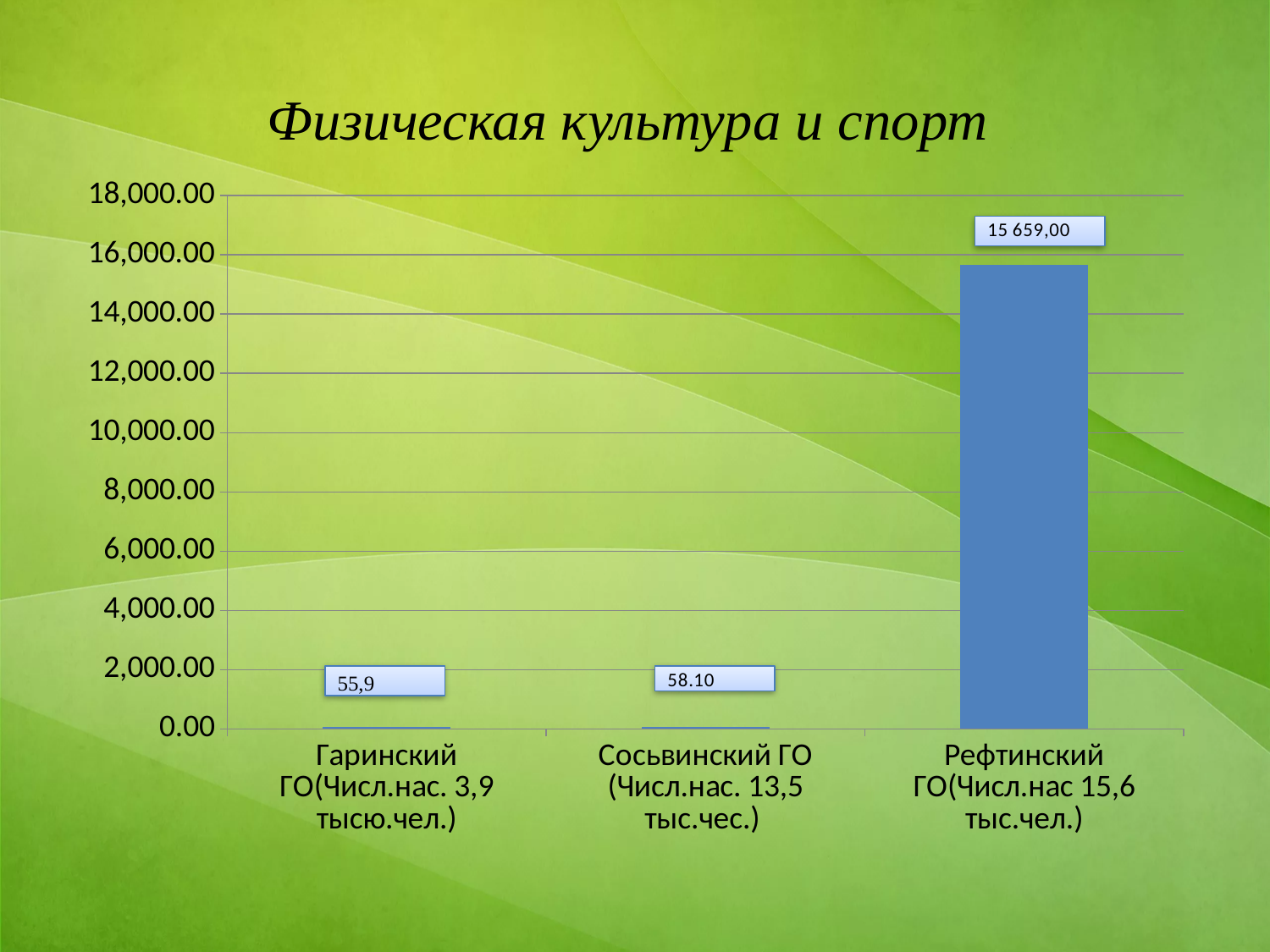
How many categories are shown on the chart? 3 What is the value shown for Гаринский ГО? 55,9 What is the value shown for Рефтинский ГО? 15 659,00 What is the title of the slide? Физическая культура и спорт Which category has the highest value? Рефтинский ГО Which category has the lowest value? Гаринский ГО Which is larger, the value for Рефтинский ГО or the value for Сосьвинский ГО? Рефтинский ГО Is the value for Гаринский ГО greater or less than 2,000.00? less Is the value for Рефтинский ГО greater or less than 14,000.00? greater What is the highest value shown on the vertical axis? 18,000.00 What is the value shown for Сосьвинский ГО? 58.10 What kind of chart is shown on the slide? bar chart